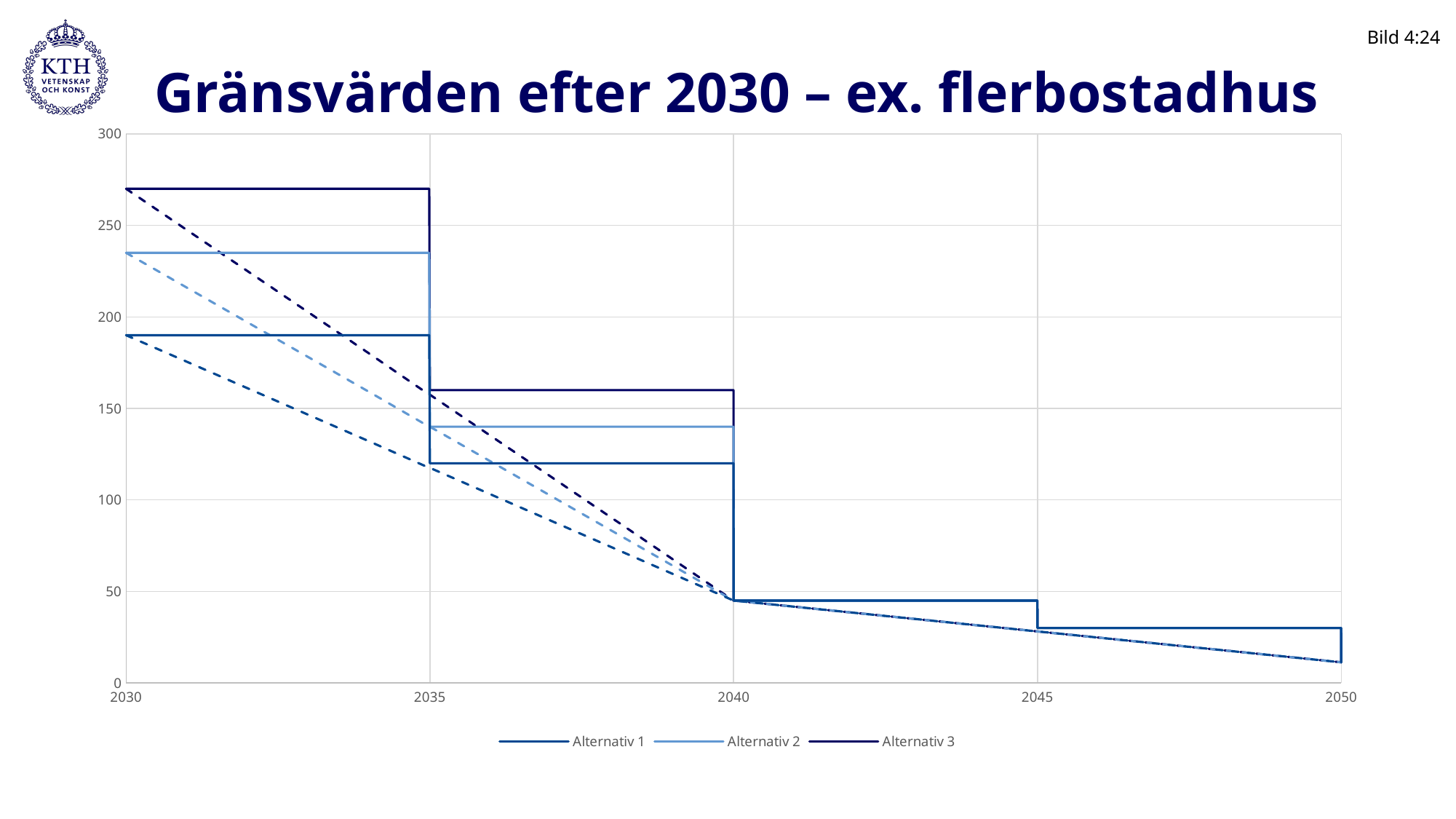
Which series has the lowest value in 2030? Alternativ 1 Is the value for Alternativ 3 between 2035 and 2040 greater or less than 150? greater Is the value for Alternativ 2 between 2035 and 2040 greater or less than 150? less Is the value for Alternativ 1 in 2030 greater or less than 200? less Do the values rise or fall from 2030 to 2050? fall What is the title of the chart on the slide? Gränsvärden efter 2030 – ex. flerbostadhus What kind of chart is shown on the slide? line chart How many series does the legend list? 3 Which is larger in 2030, Alternativ 2 or Alternativ 1? Alternativ 2 Which series has the highest value in 2030? Alternativ 3